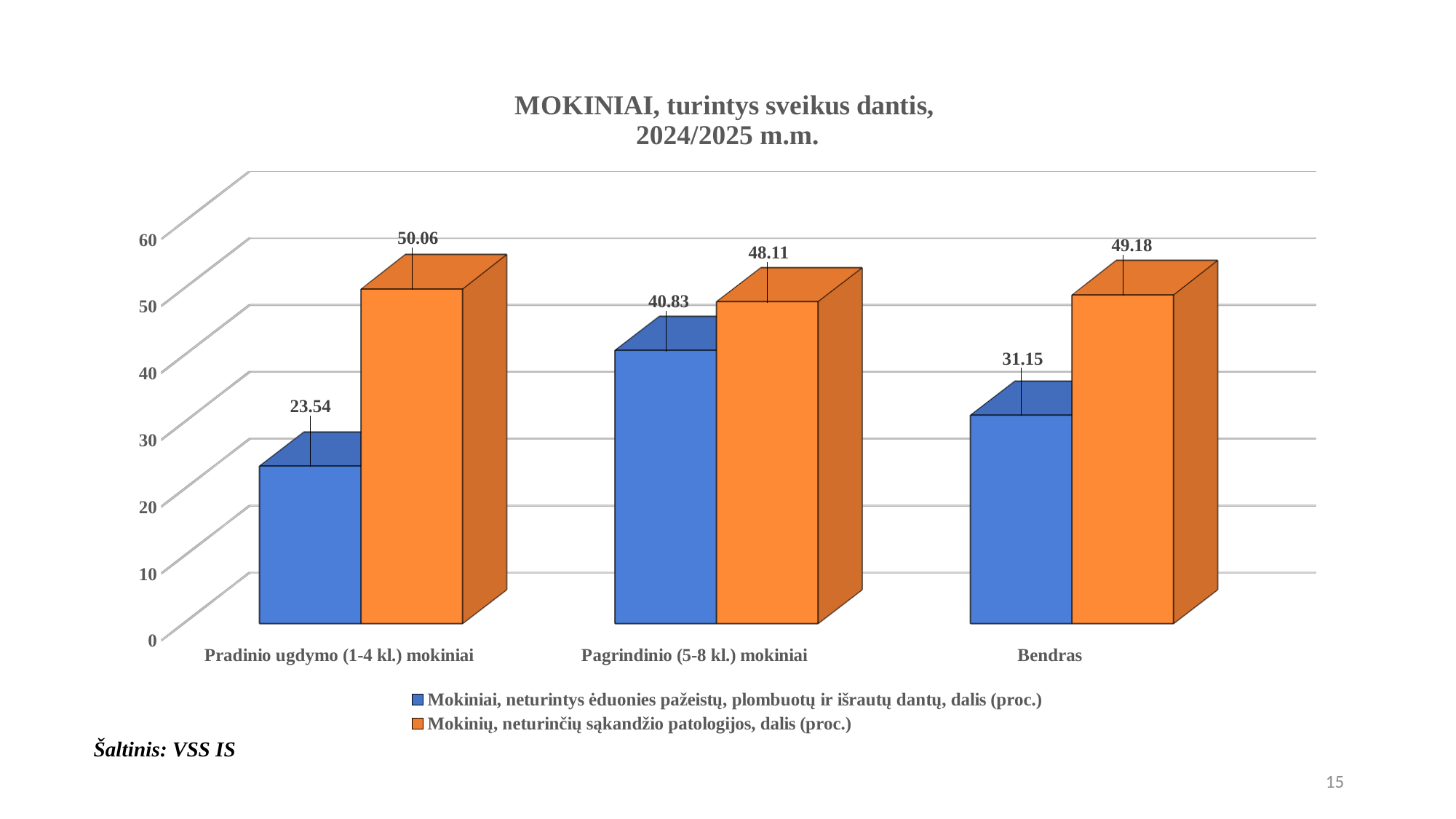
Is the value for 'Bendras' in the series 'Mokiniai, neturintys ėduonies pažeistų, plombuotų ir išrautų dantų, dalis (proc.)' greater or less than 40? less How many categories are shown on the x axis? 3 Which is larger for 'Bendras': the value for 'Mokiniai, neturintys ėduonies pažeistų, plombuotų ir išrautų dantų, dalis (proc.)' or for 'Mokinių, neturinčių sąkandžio patologijos, dalis (proc.)'? Mokinių, neturinčių sąkandžio patologijos, dalis (proc.) What is the value for 'Pradinio ugdymo (1-4 kl.) mokiniai' in the series 'Mokiniai, neturintys ėduonies pažeistų, plombuotų ir išrautų dantų, dalis (proc.)'? 23.54 How many series does the legend list? 2 What is the value for 'Bendras' in the series 'Mokinių, neturinčių sąkandžio patologijos, dalis (proc.)'? 49.18 Which category has the lowest value in the series 'Mokiniai, neturintys ėduonies pažeistų, plombuotų ir išrautų dantų, dalis (proc.)'? Pradinio ugdymo (1-4 kl.) mokiniai Which category has the highest value in the series 'Mokinių, neturinčių sąkandžio patologijos, dalis (proc.)'? Pradinio ugdymo (1-4 kl.) mokiniai What is the difference between the two series values for 'Pradinio ugdymo (1-4 kl.) mokiniai'? 26.52 What is the difference between the 'Mokinių, neturinčių sąkandžio patologijos, dalis (proc.)' values for 'Pradinio ugdymo (1-4 kl.) mokiniai' and 'Pagrindinio (5-8 kl.) mokiniai'? 1.95 What is the value for 'Pagrindinio (5-8 kl.) mokiniai' in the series 'Mokiniai, neturintys ėduonies pažeistų, plombuotų ir išrautų dantų, dalis (proc.)'? 40.83 What kind of chart is shown on the slide? bar chart